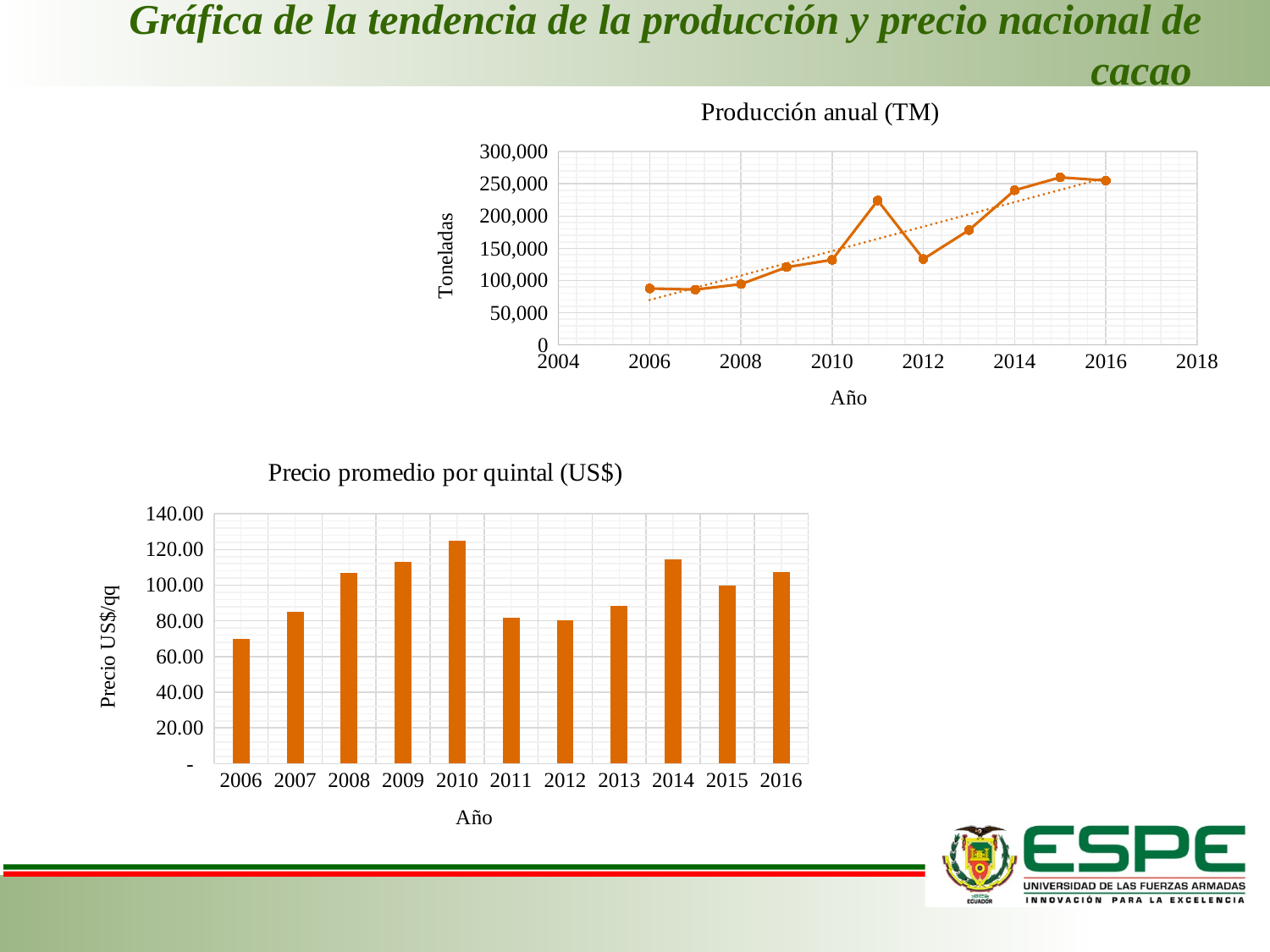
In the 'Producción anual (TM)' chart, is the value for 2011 greater or less than 200,000? greater In the 'Producción anual (TM)' chart, which is larger, the value for 2014 or the value for 2013? 2014 In the 'Precio promedio por quintal (US$)' chart, which year has the lowest price? 2006 What type of chart is the 'Producción anual (TM)' chart? line chart What type of chart is the 'Precio promedio por quintal (US$)' chart? bar chart In the 'Producción anual (TM)' chart, is the value for 2012 greater or less than 150,000? less In the 'Precio promedio por quintal (US$)' chart, which year has the highest price? 2010 What is the y-axis label of the 'Producción anual (TM)' chart? Toneladas In the 'Precio promedio por quintal (US$)' chart, which is larger, the value for 2009 or the value for 2011? 2009 In the 'Precio promedio por quintal (US$)' chart, is the value for 2006 greater or less than 80.00? less How many years are shown in the 'Precio promedio por quintal (US$)' chart? 11